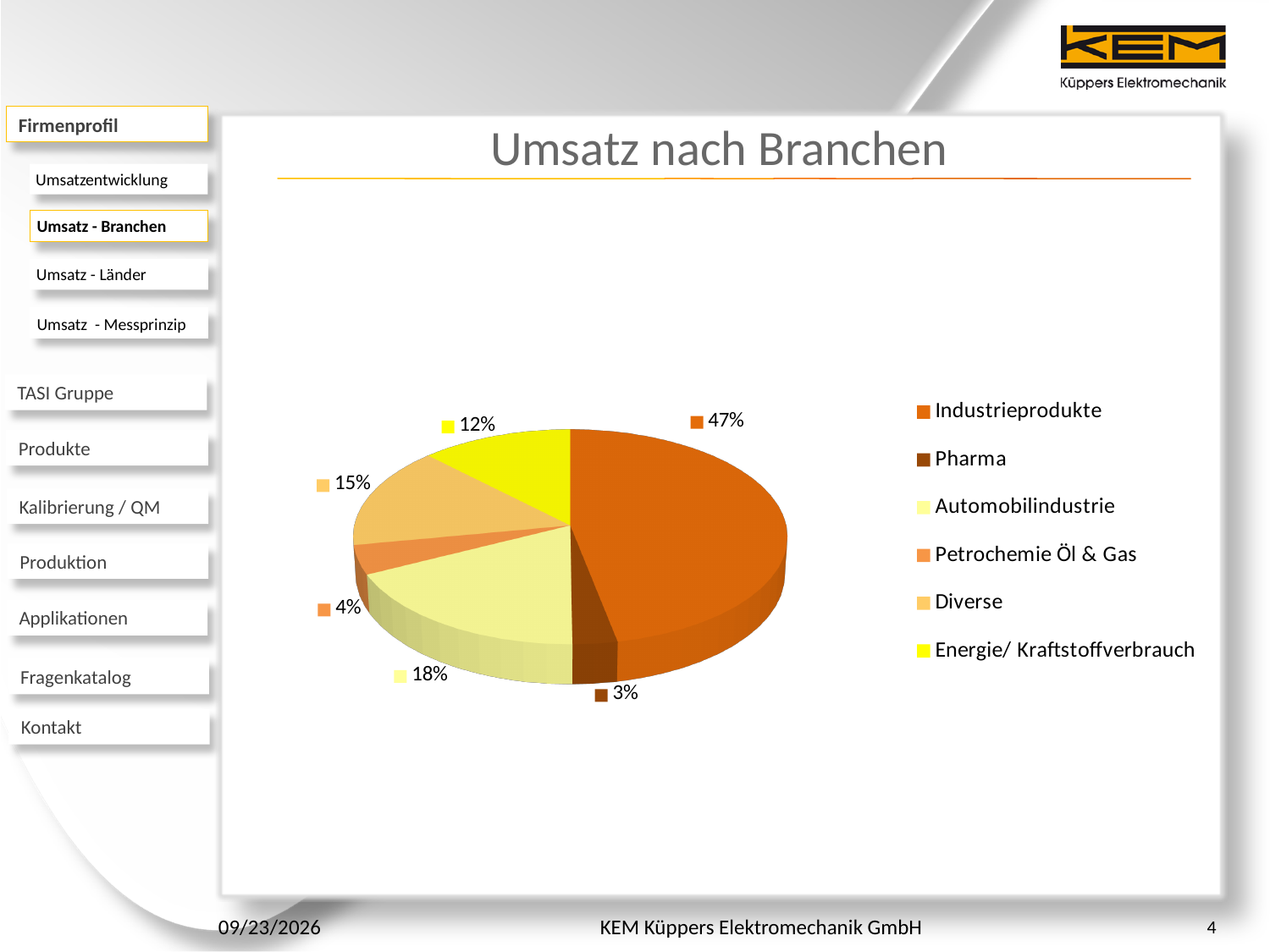
Which sector has the largest share of revenue? Industrieprodukte What type of chart is shown on the slide? Pie chart What is the difference in percentage points between Industrieprodukte and Automobilindustrie? 29 Which sector has the smallest share of revenue? Pharma What percentage does Energie/ Kraftstoffverbrauch represent? 12% What share of revenue does Industrieprodukte account for? 47% What is the value of the Pharma slice? 3% What percentage is shown for Automobilindustrie? 18% What is the combined share of Petrochemie Öl & Gas and Diverse? 19% What is the title of the chart? Umsatz nach Branchen Which has a larger share, Diverse or Energie/ Kraftstoffverbrauch? Diverse How many slices does the pie chart have? 6